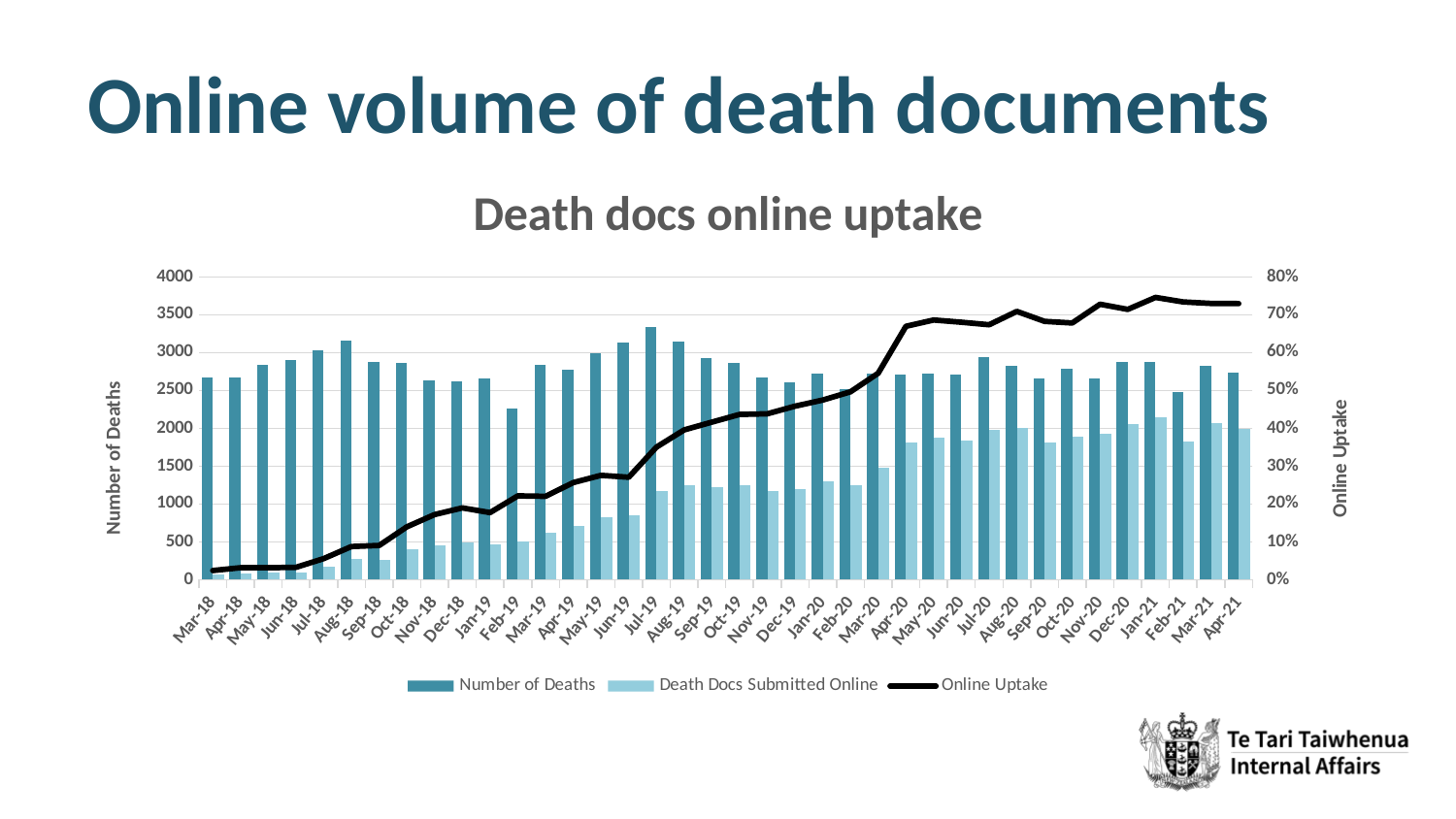
Which month has the lowest Number of Deaths? Feb-19 Is the Online Uptake for Mar-18 greater or less than 10%? less Is the Number of Deaths for Feb-19 greater or less than 2500? less Which is larger: Death Docs Submitted Online for Apr-18 or for Apr-21? Apr-21 Does the Online Uptake line generally rise or fall from Mar-18 to Apr-21? rise How many months are plotted along the x axis of the chart? 38 Which month has the highest Number of Deaths? Jul-19 Is the Online Uptake for Apr-21 greater or less than 70%? greater What is the title of the chart on the slide? Death docs online uptake How many series does the chart's legend list? 3 What kind of chart is shown on the slide? Combination bar and line chart